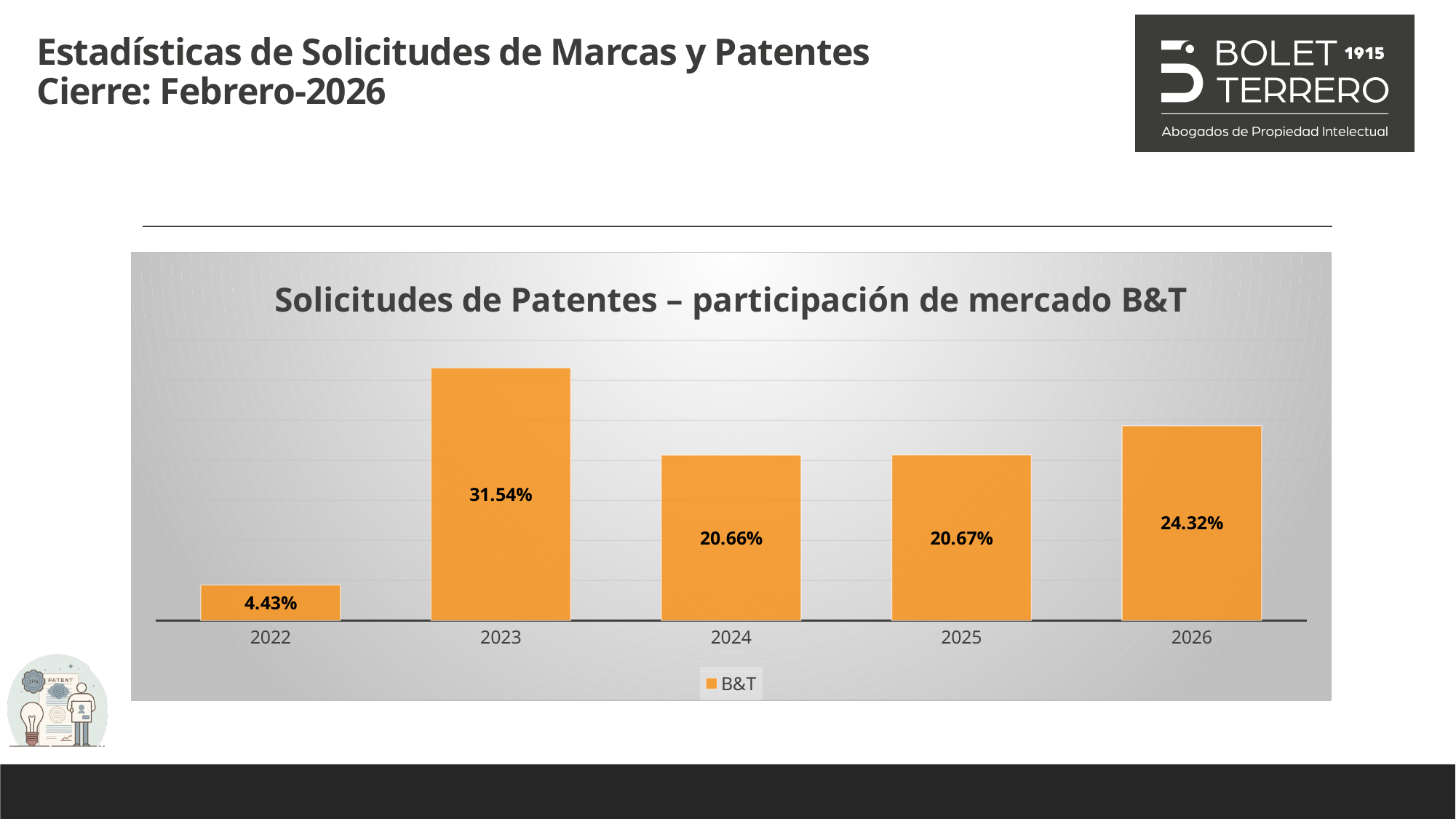
How many years are shown on the x axis of the chart? 5 What is the B&T market share for 2024? 20.66% Which year has the highest B&T market share? 2023 How many series does the legend list? 1 Which year has a larger B&T market share, 2026 or 2024? 2026 What is the difference between the B&T market share in 2026 and in 2025? 3.65% What is the B&T market share for 2022? 4.43% What is the B&T market share for 2026? 24.32% What is the B&T market share for 2023? 31.54% What type of chart is shown on the slide? Bar chart What is the difference between the B&T market share in 2023 and in 2022? 27.11% Which year has the lowest B&T market share? 2022